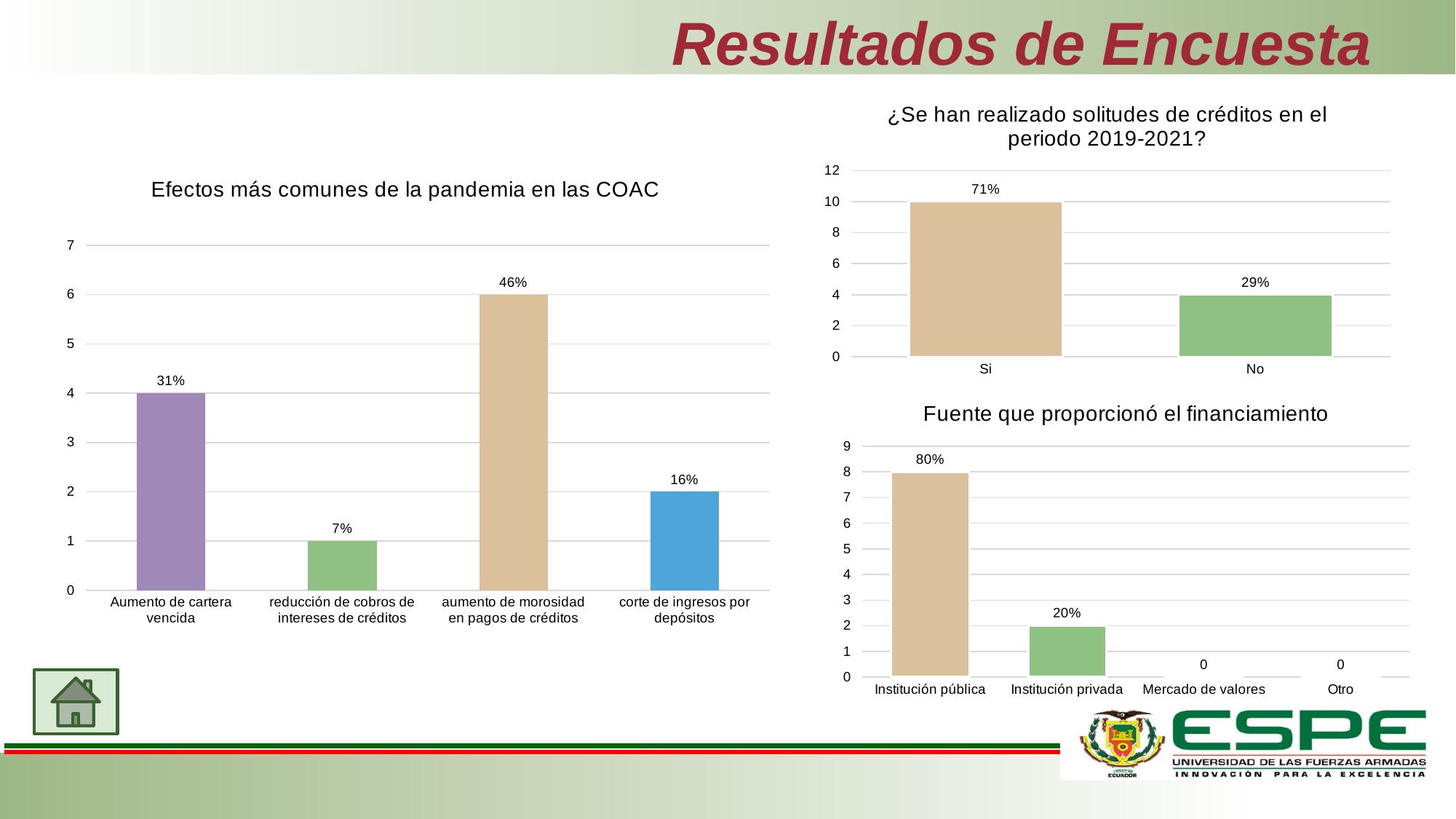
In the chart 'Fuente que proporcionó el financiamiento', which category has the highest value? Institución pública In the chart 'Efectos más comunes de la pandemia en las COAC', is the bar for 'Aumento de cartera vencida' greater or less than 3? greater In the chart 'Fuente que proporcionó el financiamiento', what is the data label for 'Institución privada'? 20% In the chart 'Efectos más comunes de la pandemia en las COAC', how many categories are shown on the x axis? 4 In the chart 'Efectos más comunes de la pandemia en las COAC', which category has the lowest value? reducción de cobros de intereses de créditos What type of chart is 'Fuente que proporcionó el financiamiento'? Bar chart In the chart 'Efectos más comunes de la pandemia en las COAC', what is the data label for 'aumento de morosidad en pagos de créditos'? 46% In the chart '¿Se han realizado solitudes de créditos en el periodo 2019-2021?', is the bar for 'No' greater or less than 6? less In the chart '¿Se han realizado solitudes de créditos en el periodo 2019-2021?', what is the difference in percentage points between the 'Si' and 'No' labels? 42 In the chart '¿Se han realizado solitudes de créditos en el periodo 2019-2021?', what is the data label for 'Si'? 71% In the chart 'Fuente que proporcionó el financiamiento', what is the data label shown for 'Mercado de valores'? 0 In the chart 'Efectos más comunes de la pandemia en las COAC', which category has the highest value? aumento de morosidad en pagos de créditos